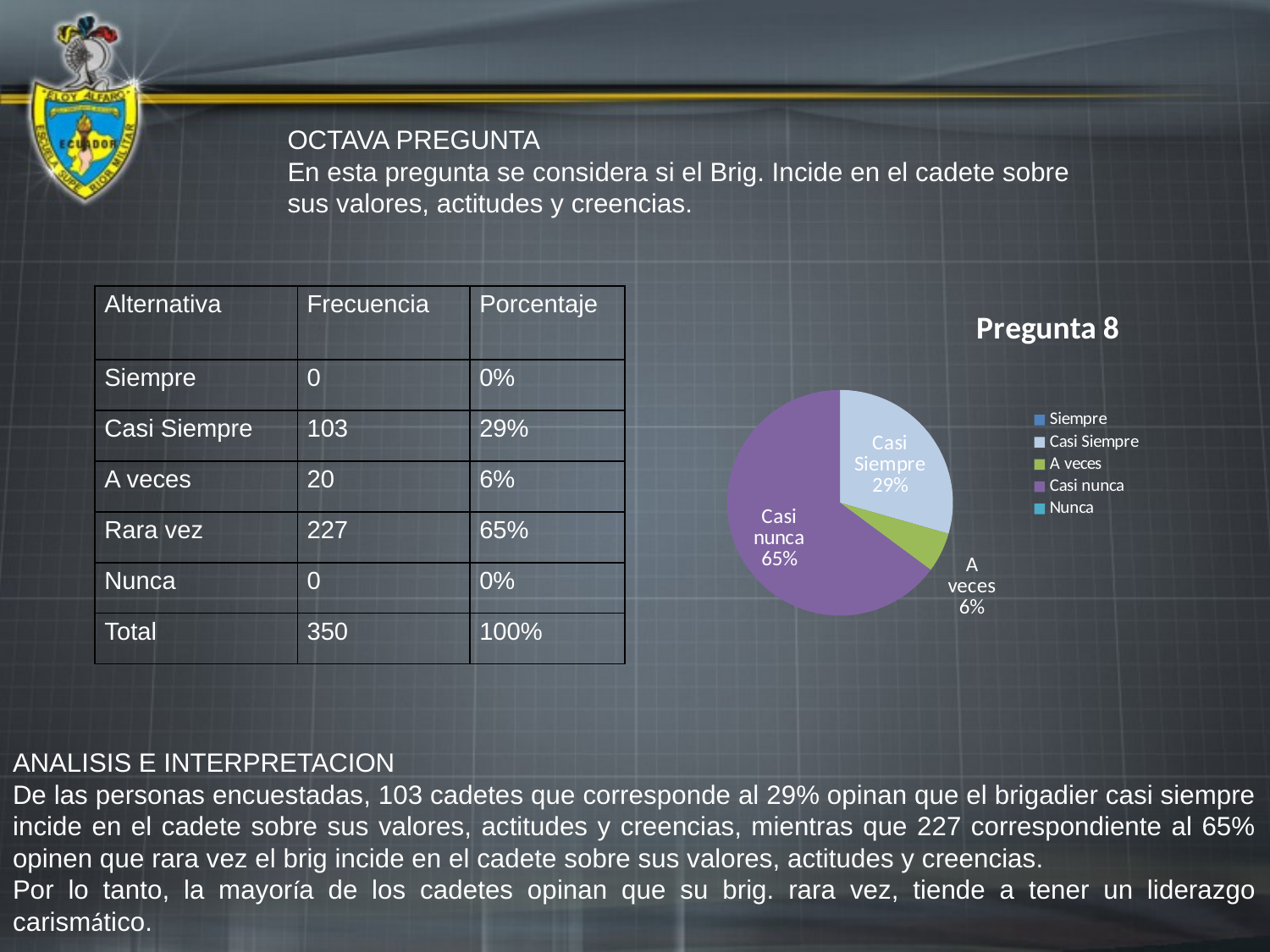
How many entries does the legend list? 5 Which slice of the pie is the largest? Casi nunca What percentage does the Casi nunca slice show? 65% Is the share of the Casi nunca slice greater or less than 50%? greater What percentage does the Casi Siempre slice show? 29% Which is larger, the Casi Siempre slice or the A veces slice? Casi Siempre What is the combined share of the Casi Siempre and A veces slices? 35% What kind of chart is shown on the slide? pie chart What is the title of the chart? Pregunta 8 What percentage does the A veces slice show? 6% What is the difference in percentage points between the Casi nunca slice and the Casi Siempre slice? 36 Which labelled slice of the pie is the smallest? A veces